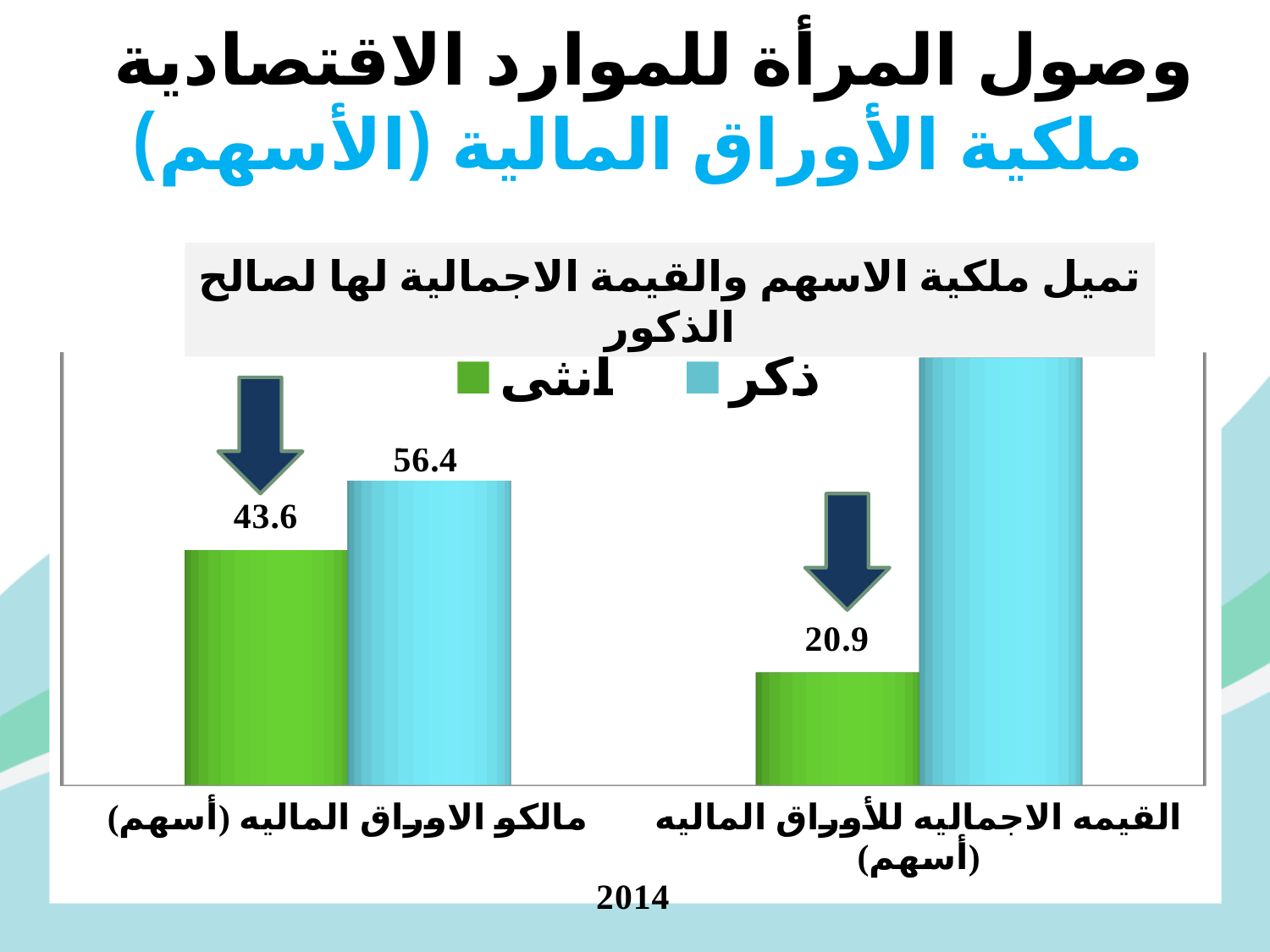
What is the difference between the ذكر and أنثى values in the مالكو الاوراق الماليه (أسهم) category? 12.8 What year is shown below the chart's x axis? 2014 How many series does the legend list? 2 In the مالكو الاوراق الماليه (أسهم) category, which series has the larger value, أنثى or ذكر? ذكر What kind of chart is shown on the slide? Bar chart Which colour represents the أنثى series in the legend? Green Which bar in the chart is the highest? ذكر in القيمه الاجماليه للأوراق الماليه (أسهم) Which bar in the chart is the lowest? أنثى in القيمه الاجماليه للأوراق الماليه (أسهم) What is the value for ذكر (male) in the مالكو الاوراق الماليه (أسهم) category? 56.4 How many categories are shown on the x axis? 2 What is the value for أنثى (female) in the القيمه الاجماليه للأوراق الماليه (أسهم) category? 20.9 What is the value for أنثى (female) in the مالكو الاوراق الماليه (أسهم) category? 43.6